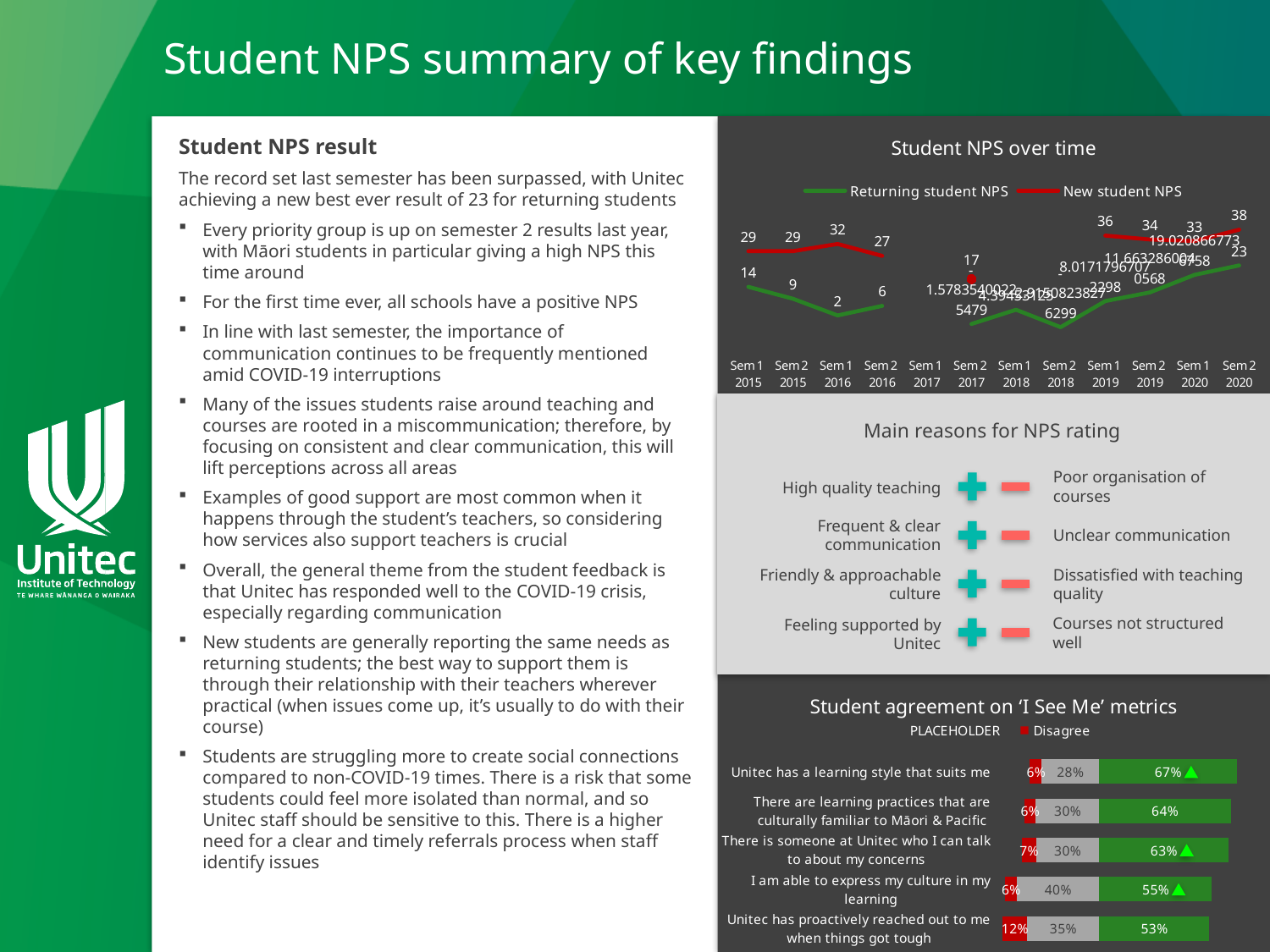
In the 'Student agreement on ‘I See Me’ metrics' chart, what is the Disagree value for 'Unitec has proactively reached out to me when things got tough'? 12% In the 'Student NPS over time' chart, how many series does the legend list? 2 What kind of chart is the 'Student NPS over time' chart? Line chart In the 'Student NPS over time' chart, which semester has the highest New student NPS? Sem 2 2020 In the 'Student NPS over time' chart, what is the New student NPS for Sem 2 2020? 38 What kind of chart is the 'Student agreement on ‘I See Me’ metrics' chart? Bar chart In the 'Student NPS over time' chart, what is the difference between the New student NPS and the Returning student NPS in Sem 2 2020? 15 How many semesters are shown on the x axis of the 'Student NPS over time' chart? 12 How many statements are listed in the 'Student agreement on ‘I See Me’ metrics' chart? 5 In the 'Student NPS over time' chart, what is the Returning student NPS for Sem 2 2020? 23 In the 'Student agreement on ‘I See Me’ metrics' chart, what is the value of the green segment for 'Unitec has a learning style that suits me'? 67% In the 'Student NPS over time' chart, what is the Returning student NPS for Sem 1 2015? 14